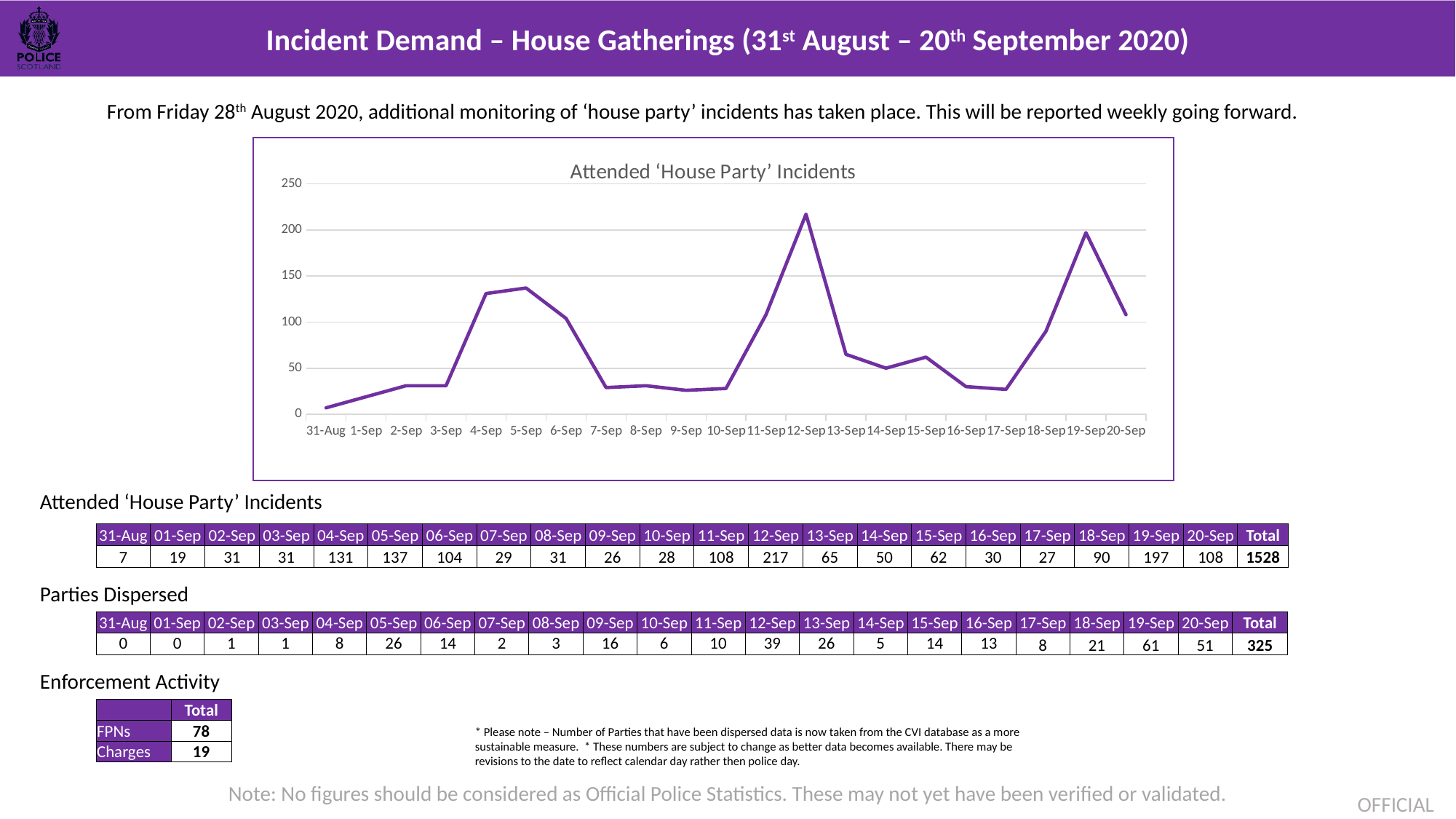
Is the value for 7-Sep on the 'Attended ‘House Party’ Incidents' chart greater or less than 50? less What is the value of attended house party incidents on 19-Sep? 197 What is the difference between the attended house party incidents on 12-Sep and 19-Sep? 20 On which date does the 'Attended ‘House Party’ Incidents' line have its lowest value? 31-Aug Which date has the higher value of attended house party incidents, 5-Sep or 6-Sep? 5-Sep Does the 'Attended ‘House Party’ Incidents' line rise or fall between 12-Sep and 13-Sep? fall What type of chart is 'Attended ‘House Party’ Incidents'? line chart What is the value of attended house party incidents on 12-Sep? 217 Is the value for 12-Sep on the 'Attended ‘House Party’ Incidents' chart greater or less than 200? greater On which date does the 'Attended ‘House Party’ Incidents' line reach its highest value? 12-Sep How many dates are plotted along the x axis of the 'Attended ‘House Party’ Incidents' chart? 21 What is the title of the chart on the slide? Attended ‘House Party’ Incidents